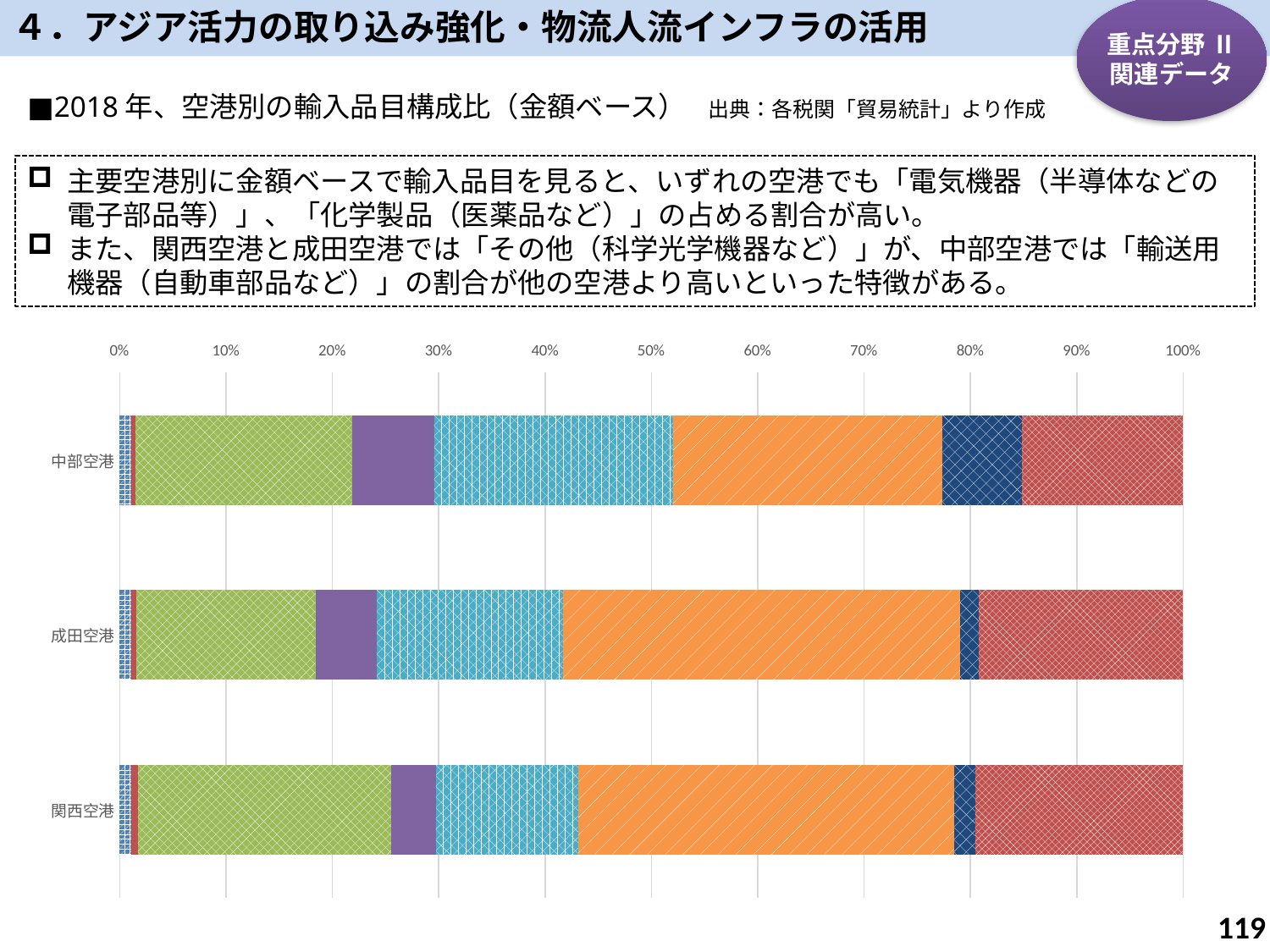
In the 中部空港 bar, does the green segment end at a value greater or less than 20%? greater What is the maximum value shown on the horizontal axis of the chart? 100% Which airport is listed at the bottom of the chart? 関西空港 How many airports (categories) are plotted in the chart? 3 In the 成田空港 bar, does the green segment end at a value greater or less than 20%? less Which airport has the widest purple segment: 中部空港 or 関西空港? 中部空港 Which airport has the widest green segment: 成田空港 or 関西空港? 関西空港 In the 関西空港 bar, does the green segment end at a value greater or less than 20%? greater Which airport has the widest dark blue segment: 中部空港 or 成田空港? 中部空港 Which airport is listed at the top of the chart? 中部空港 What kind of chart is shown on the slide? stacked bar chart